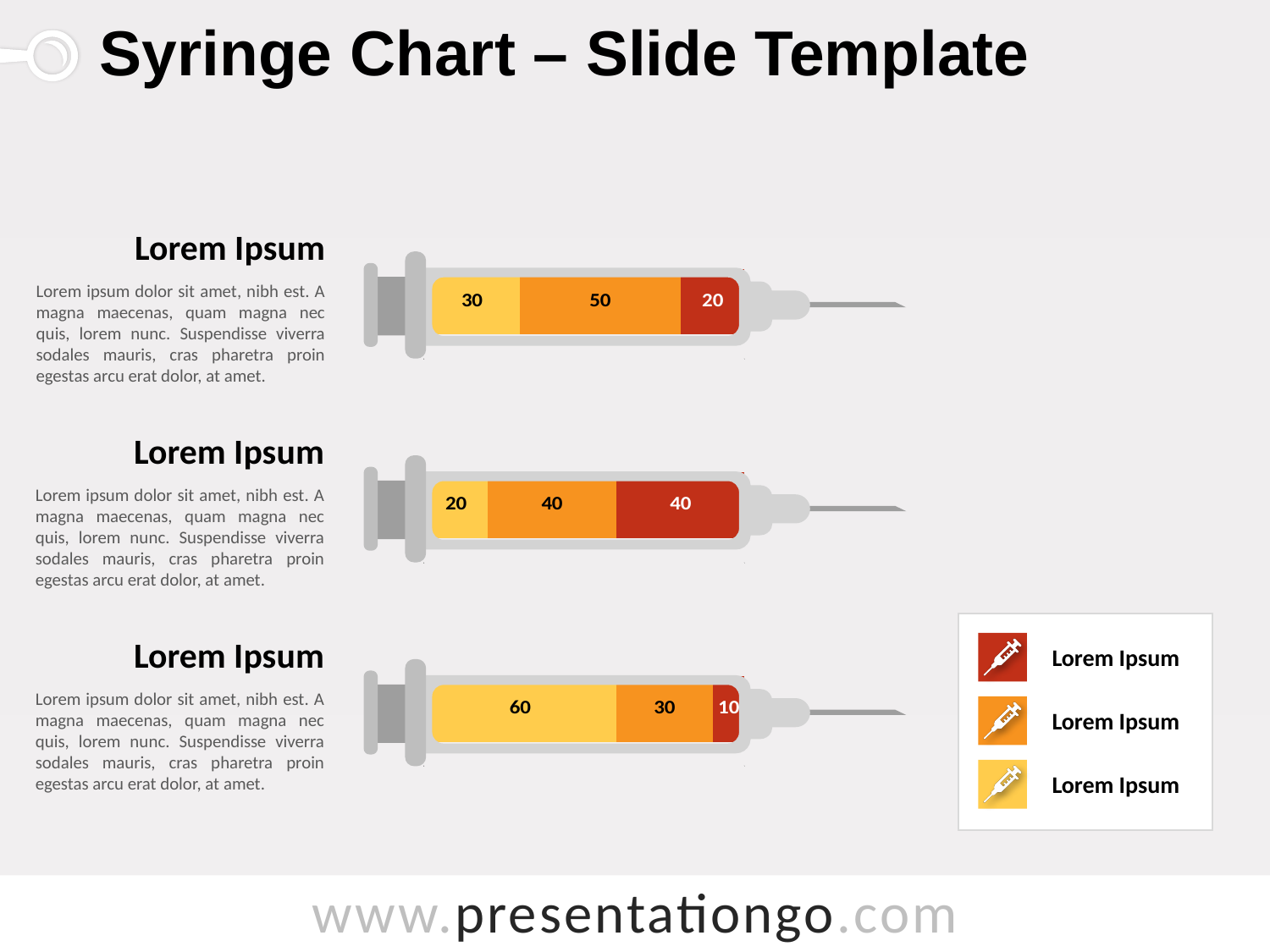
What is the value of the red segment in the bottom syringe? 10 Which segment is the largest in the top syringe? the orange segment (50) What is the difference between the orange and red segments in the top syringe? 30 What is the total of the three segments in the middle syringe? 100 How many syringe bars are shown on the slide? 3 What is the value of the yellow segment in the top syringe? 30 What is the value of the orange segment in the top syringe? 50 What is the total of the three segments in the top syringe? 100 What is the value of the red segment in the middle syringe? 40 In the bottom syringe, which is larger, the yellow segment or the orange segment? the yellow segment How many entries does the legend list? 3 What is the value of the yellow segment in the bottom syringe? 60